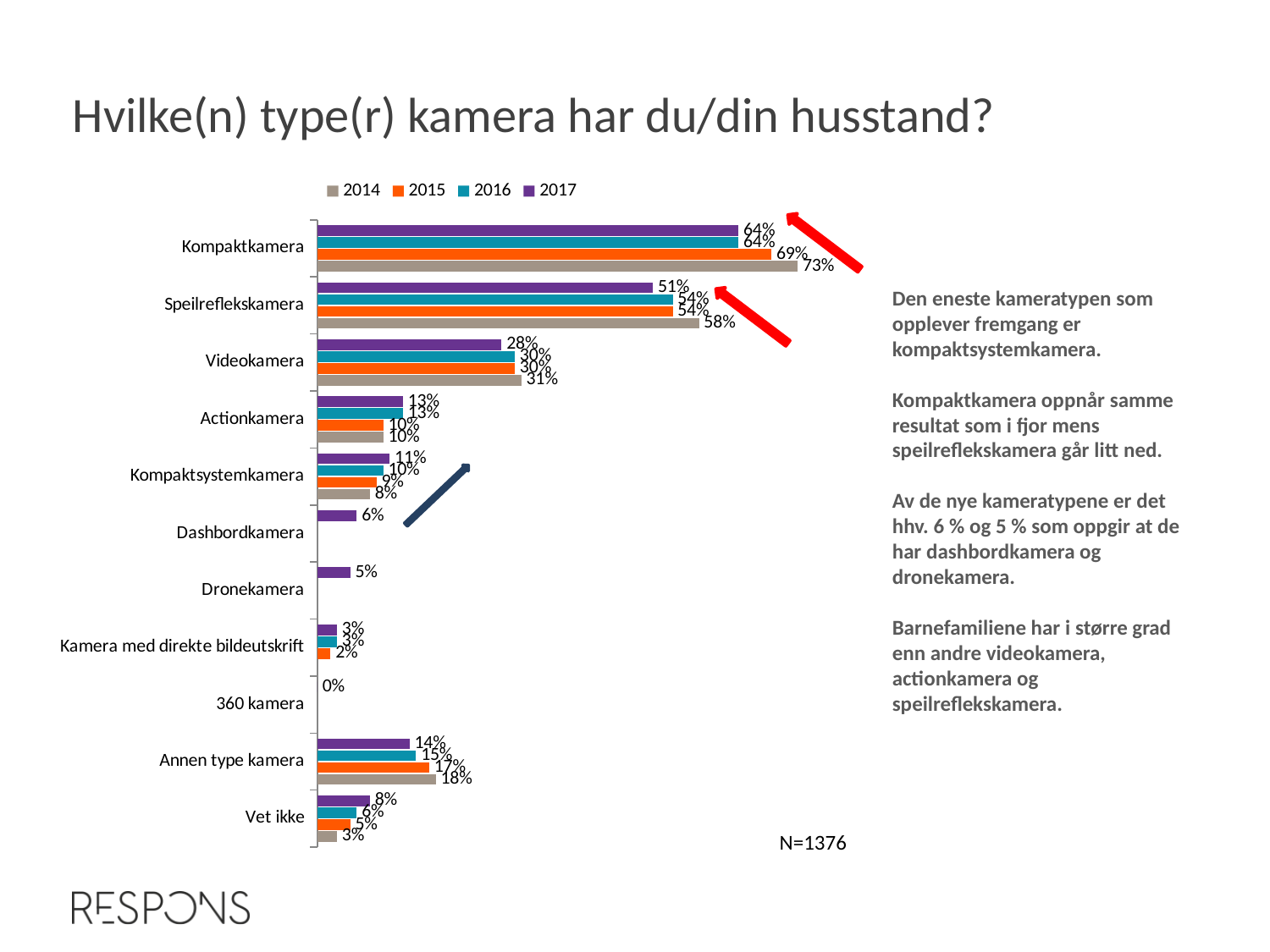
What is the 2017 value for Dronekamera? 5% What is the difference between the 2014 and 2017 values for Kompaktkamera? 9% How many series does the legend list? 4 Which camera type has the highest 2017 value? Kompaktkamera Which camera type has the lowest value shown on the chart? 360 kamera What is the 2017 value for Speilreflekskamera? 51% What is the sample size (N) shown on the slide? N=1376 What is the 2017 value for Dashbordkamera? 6% What is the 2014 value for Kompaktkamera? 73% What kind of chart is shown on the slide? bar chart Which is larger for Vet ikke: the 2017 value or the 2014 value? 2017 Do the values for Kompaktsystemkamera rise or fall from 2014 to 2017? rise